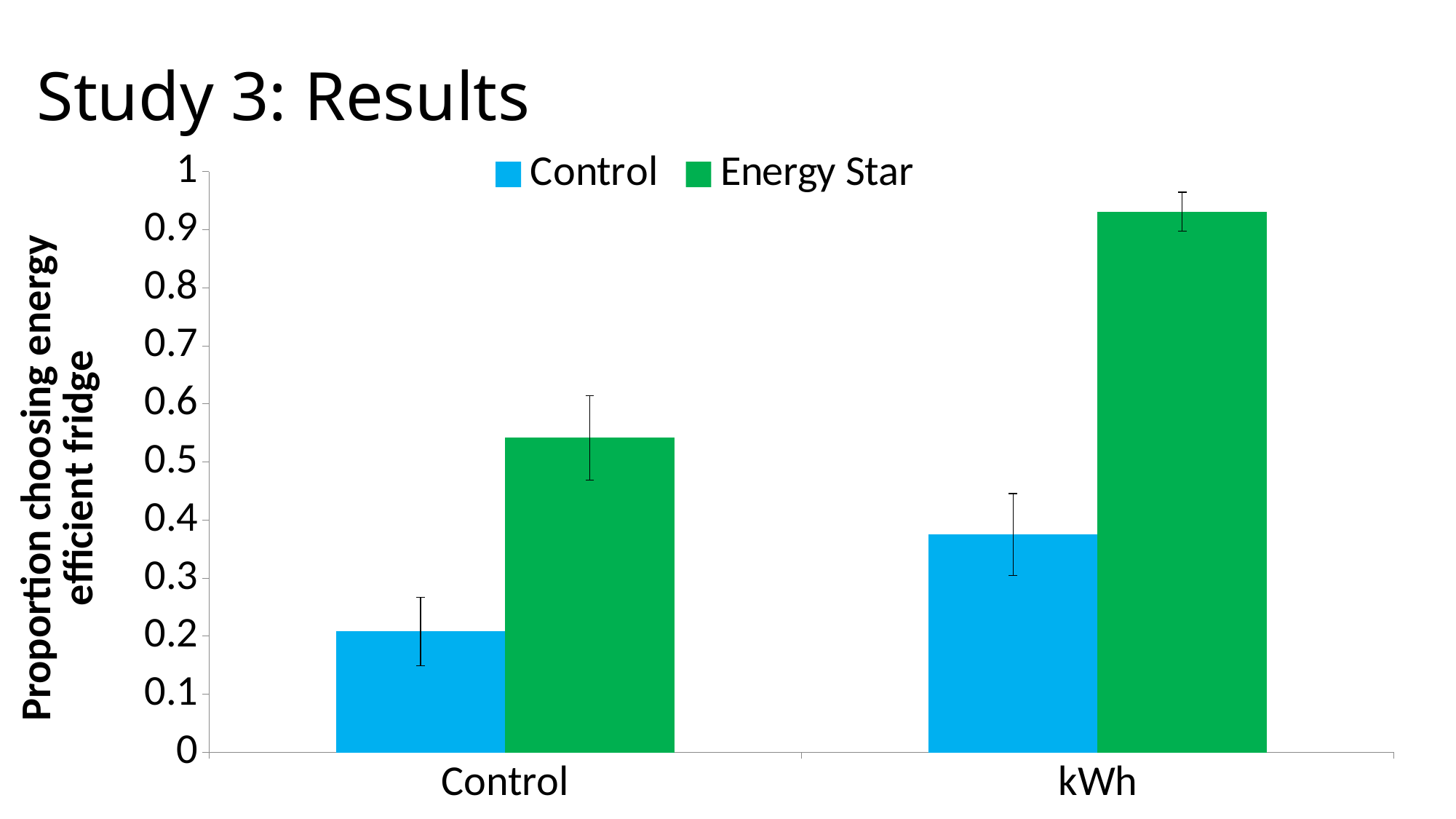
Which series has the highest bar in the chart? Energy Star What kind of chart is shown on the slide? bar chart How many series does the legend list? 2 Is the Energy Star value for the kWh condition greater or less than 0.8? greater Which condition has the larger Energy Star value, Control or kWh? kWh What is the label of the y axis? Proportion choosing energy efficient fridge Is the Control series value for the Control condition greater or less than 0.3? less How many categories are shown on the x axis? 2 Is the Control series value for the kWh condition greater or less than 0.3? greater In the kWh condition, which series has the larger value, Control or Energy Star? Energy Star Which bar is the lowest in the chart? Control in the Control condition